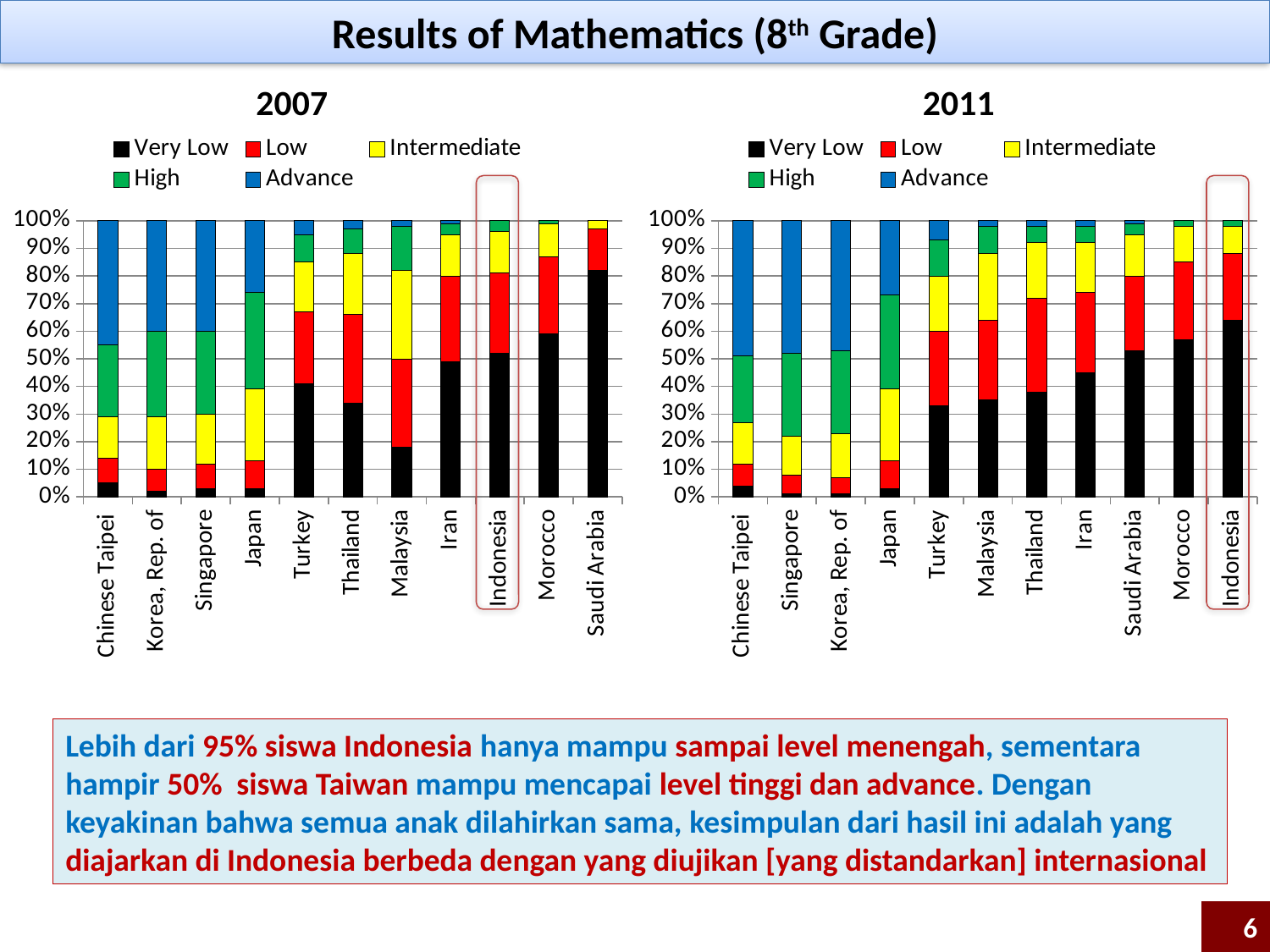
In the 2011 chart, which has the larger Very Low segment, Turkey or Saudi Arabia? Saudi Arabia In the 2007 chart, is the Very Low value for Chinese Taipei greater or less than 10%? less In the 2011 chart, which country has the largest Very Low segment? Indonesia In the 2007 chart, which has the larger Very Low segment, Iran or Morocco? Morocco How many countries are shown on the x axis of the 2007 chart? 11 How many countries are shown on the x axis of the 2011 chart? 11 Which series is shown in blue in the legend of the 2007 chart? Advance In the 2011 chart, does the Very Low segment rise or fall moving from left to right along the x axis? rise What kind of chart is the 2007 chart? stacked bar chart In the 2007 chart, which country has the largest Very Low segment? Saudi Arabia In the 2011 chart, is the Very Low value for Indonesia greater or less than 60%? greater How many series does the legend of the 2011 chart list? 5